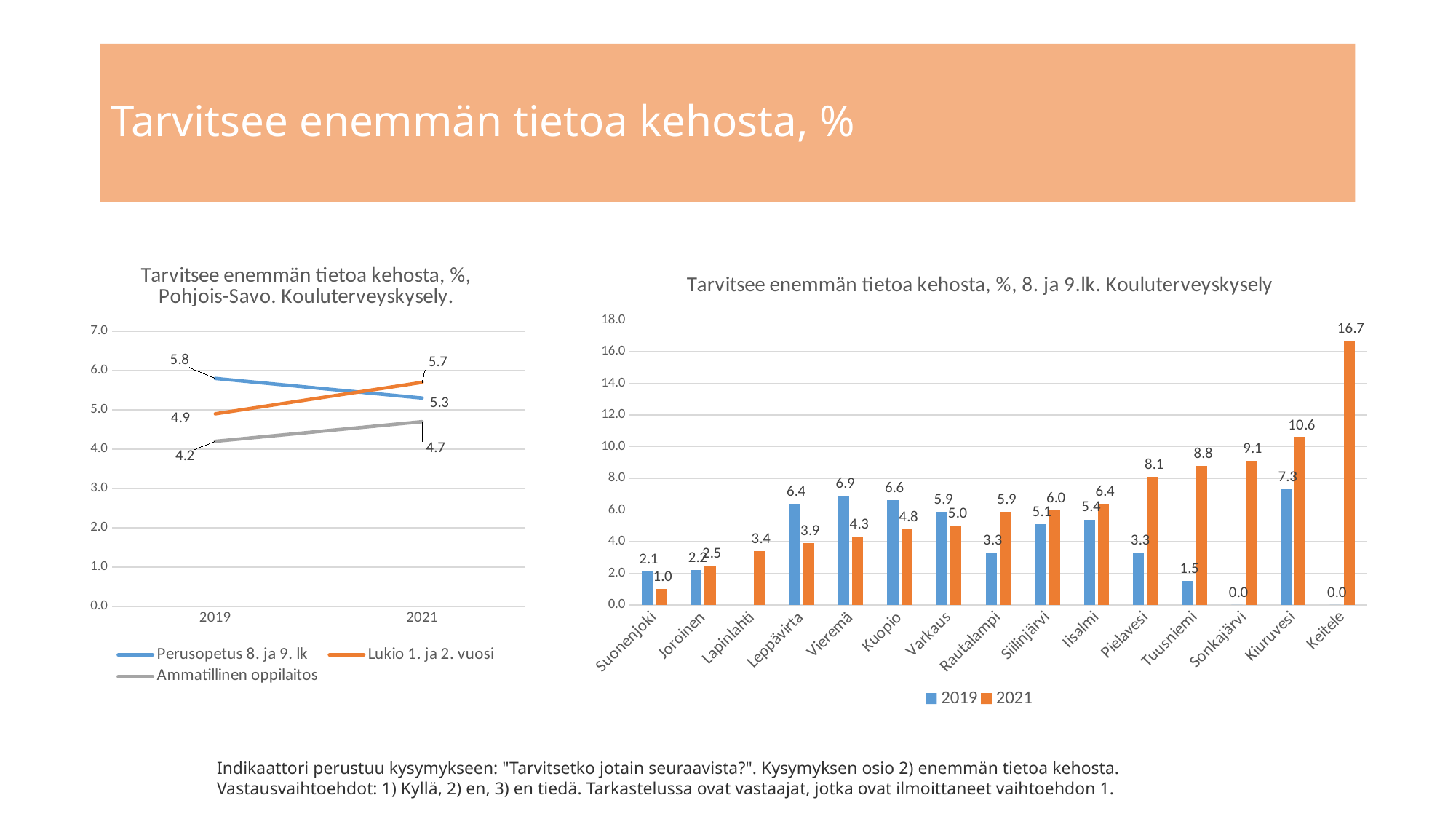
In the right chart (8. ja 9.lk), what is the 2019 value for Vieremä? 6.9 In the left chart (Pohjois-Savo), what is the value for Lukio 1. ja 2. vuosi in 2021? 5.7 In the right chart (8. ja 9.lk), which municipality has the highest 2021 value? Keitele In the right chart (8. ja 9.lk), which municipality has the lowest 2021 value? Suonenjoki In the right chart (8. ja 9.lk), which is larger for Kuopio, the 2019 value or the 2021 value? 2019 In the left chart (Pohjois-Savo), does the Ammatillinen oppilaitos line rise or fall from 2019 to 2021? rise In the left chart (Pohjois-Savo), how many series does the legend list? 3 In the left chart (Pohjois-Savo), what is the value for Perusopetus 8. ja 9. lk in 2019? 5.8 In the right chart (8. ja 9.lk), what is the difference between the 2021 and 2019 values for Tuusniemi? 7.3 In the right chart (8. ja 9.lk), what is the 2021 value for Keitele? 16.7 In the right chart (8. ja 9.lk), how many municipalities are shown on the x axis? 15 In the left chart (Pohjois-Savo), what is the difference between the Perusopetus 8. ja 9. lk values in 2019 and 2021? 0.5